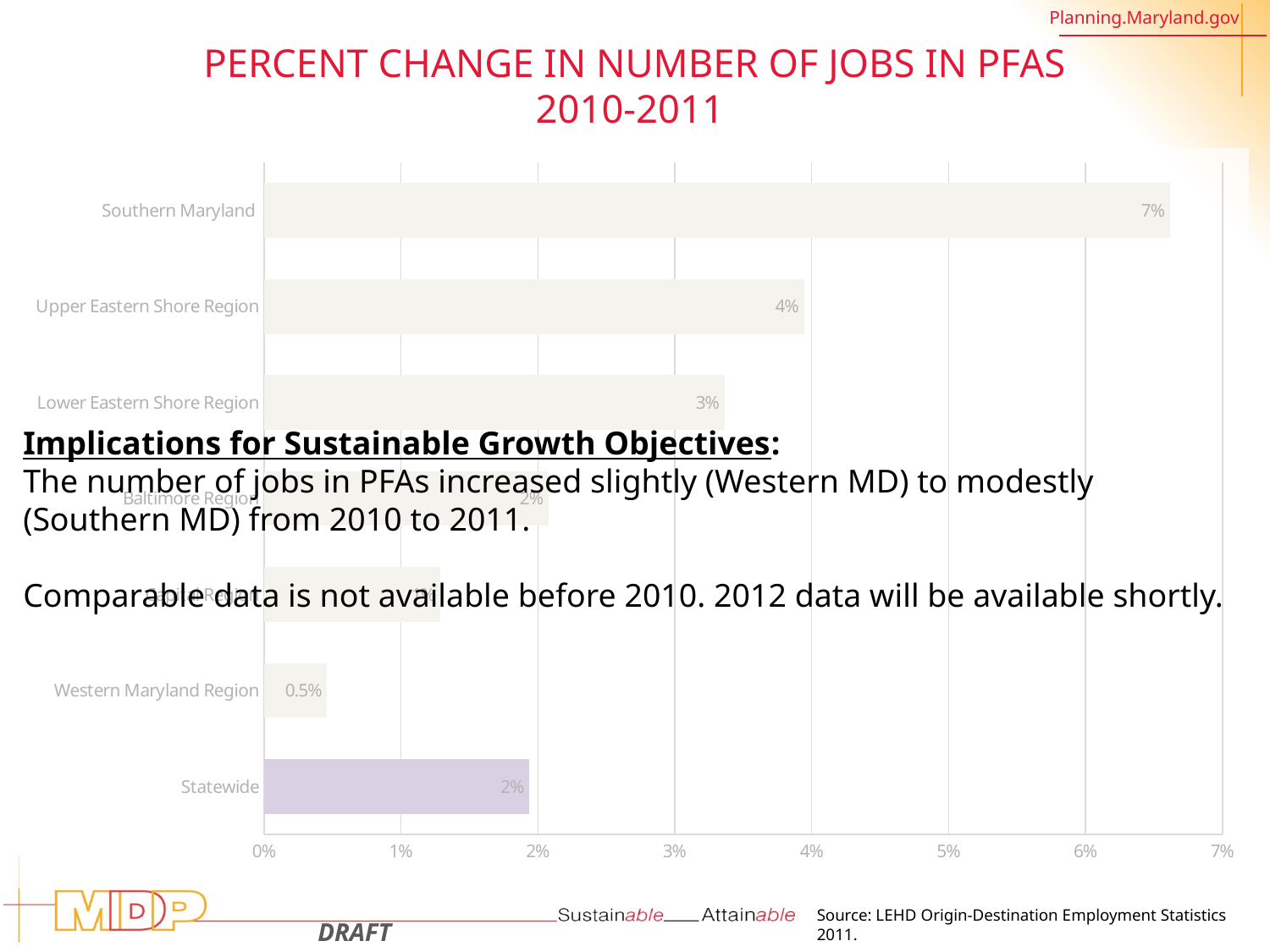
How many bars are plotted in the chart? 7 What is the value shown for the Western Maryland Region? 0.5% Which has a larger value, the Upper Eastern Shore Region or the Lower Eastern Shore Region? Upper Eastern Shore Region What is the Statewide percent change in number of jobs in PFAs? 2% What is the value shown for the Lower Eastern Shore Region? 3% What is the title of the chart? PERCENT CHANGE IN NUMBER OF JOBS IN PFAS 2010-2011 What is the difference between the values for Southern Maryland and the Upper Eastern Shore Region? 3% Which region has the highest percent change in number of jobs in PFAs? Southern Maryland Which region has the lowest percent change in number of jobs in PFAs? Western Maryland Region What is the value shown for the Upper Eastern Shore Region? 4% What is the percent change in number of jobs in PFAs for Southern Maryland? 7% What kind of chart is shown on the slide? Bar chart